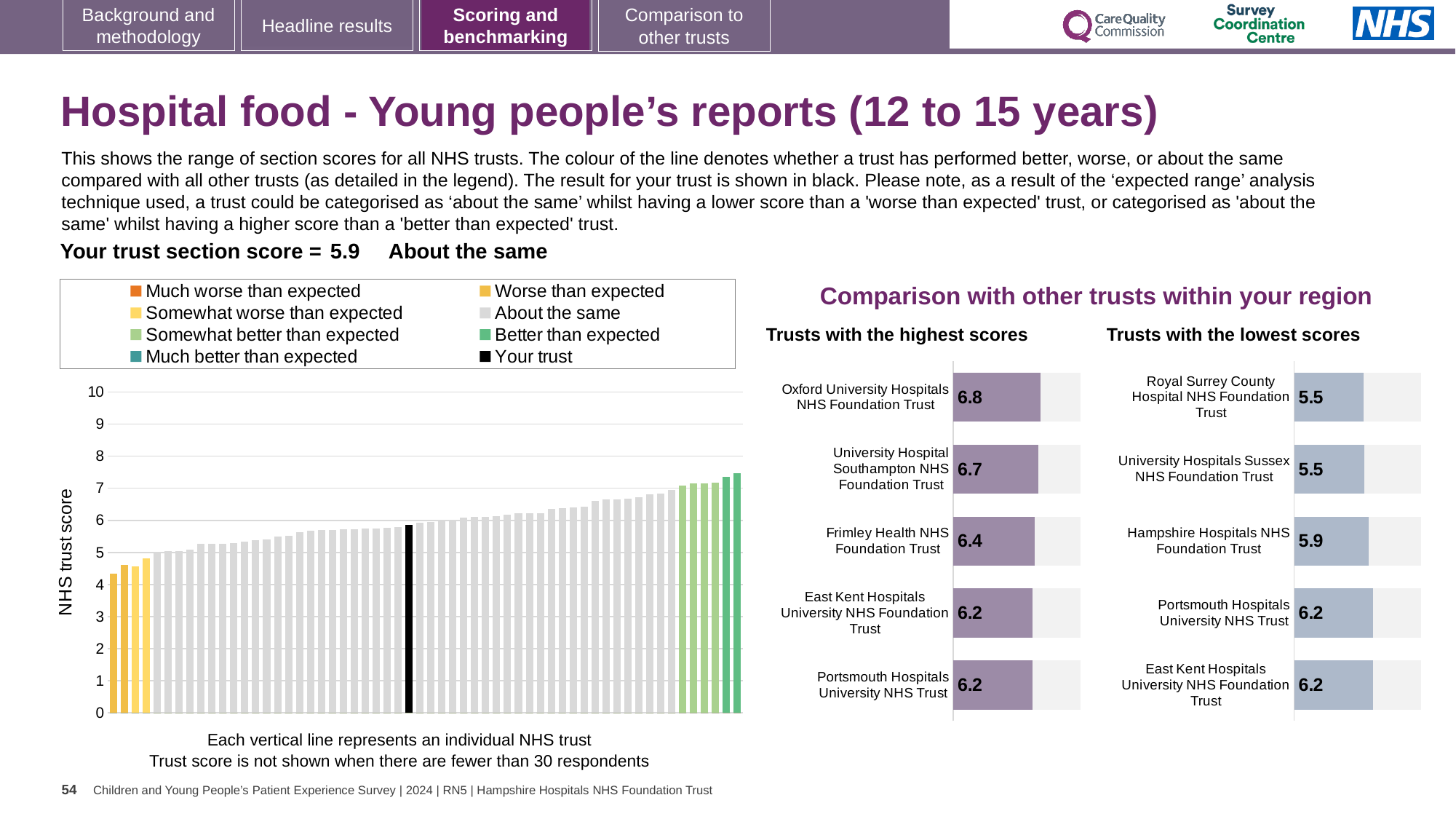
What kind of chart is the NHS trust score chart on the left? bar chart In the NHS trust score chart on the left, is the value of the highest bar greater or less than 7? greater In the 'Trusts with the lowest scores' chart, what is the difference between the scores of Hampshire Hospitals NHS Foundation Trust and Royal Surrey County Hospital NHS Foundation Trust? 0.4 In the NHS trust score chart on the left, do the bar values rise or fall from left to right? rise How many trusts are listed in the 'Trusts with the lowest scores' chart? 5 In the 'Trusts with the lowest scores' chart, what is the score for Hampshire Hospitals NHS Foundation Trust? 5.9 In the 'Trusts with the highest scores' chart, what is the score for Oxford University Hospitals NHS Foundation Trust? 6.8 In the 'Trusts with the highest scores' chart, what is the difference between the scores of Oxford University Hospitals NHS Foundation Trust and Frimley Health NHS Foundation Trust? 0.4 In the 'Trusts with the highest scores' chart, which has the larger score: University Hospital Southampton NHS Foundation Trust or Frimley Health NHS Foundation Trust? University Hospital Southampton NHS Foundation Trust In the NHS trust score chart on the left, is the value of the lowest bar greater or less than 5? less How many entries does the legend of the NHS trust score chart on the left list? 8 In the 'Trusts with the highest scores' chart, which trust has the highest score? Oxford University Hospitals NHS Foundation Trust